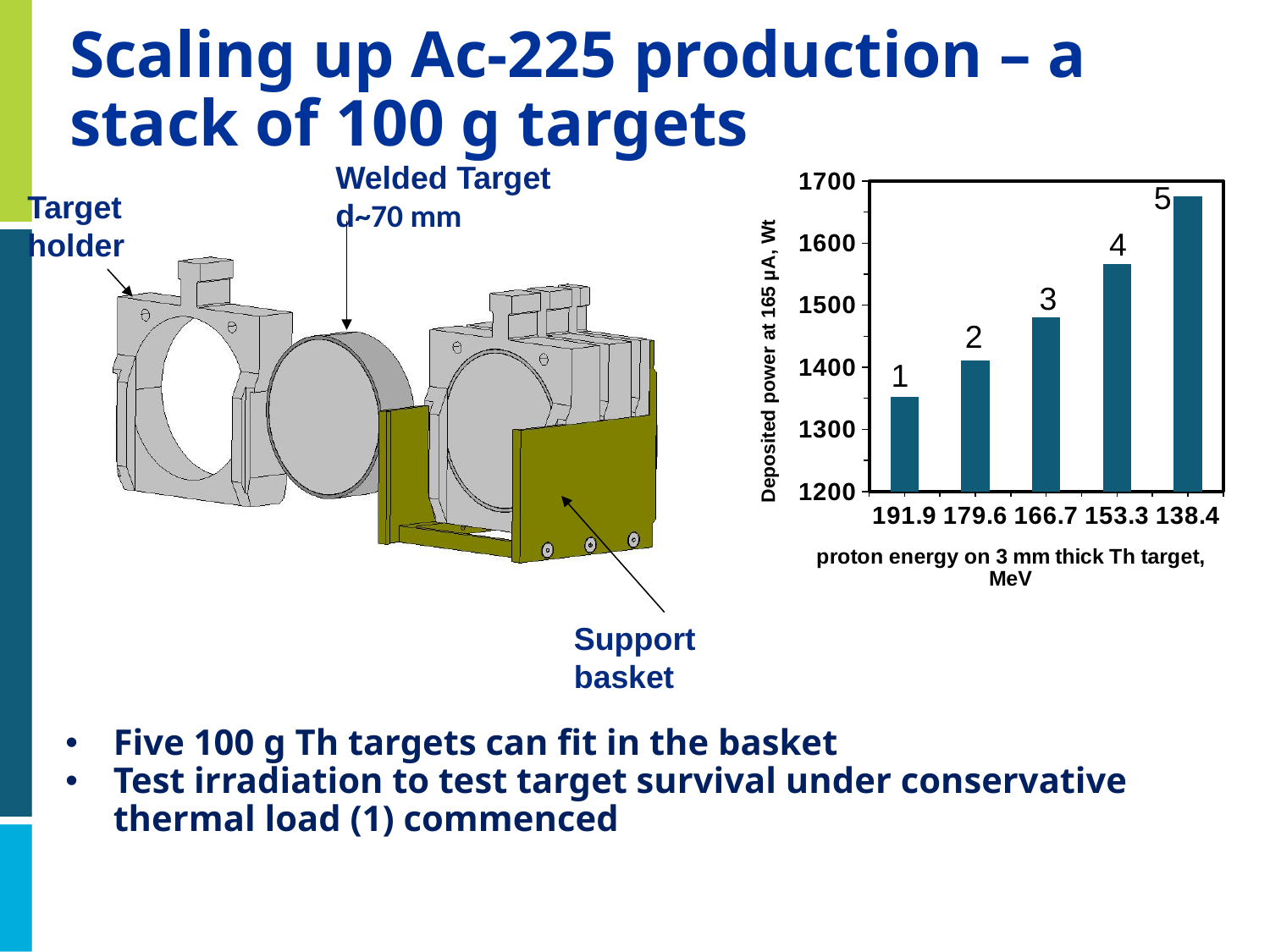
Is the deposited power for the 191.9 MeV category greater or less than 1400? less Is the deposited power for the 153.3 MeV category greater or less than 1500? greater What kind of chart is shown on the slide? bar chart Is the deposited power for the 191.9 MeV category greater or less than 1300? greater Which proton energy category has the highest deposited power? 138.4 How many bars (proton energy categories) are plotted in the chart? 5 What is the title of the chart's y axis? Deposited power at 165 µA, Wt Which proton energy category has the lowest deposited power? 191.9 Which has the larger deposited power, the 179.6 MeV category or the 153.3 MeV category? 153.3 Do the bar values rise or fall moving from left to right along the x axis? rise